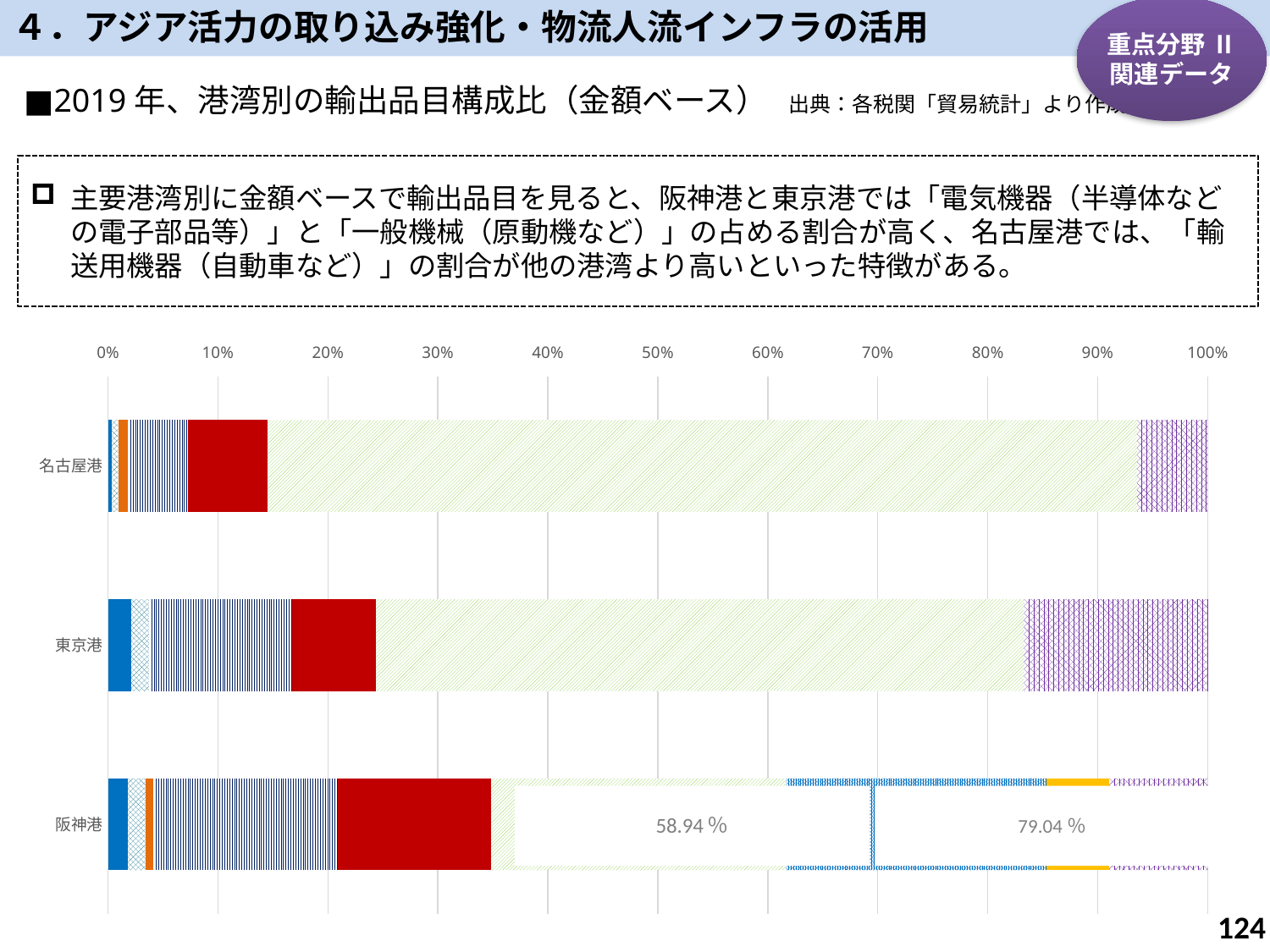
Is the red segment larger for 阪神港 or for 名古屋港? 阪神港 What is the total of each stacked bar, as shown by the right end of the bars on the axis? 100% How many ports (categories) are plotted in the chart? 3 Which port is shown in the top bar of the chart? 名古屋港 What is the title of the chart on the slide? 2019年、港湾別の輸出品目構成比（金額ベース） Is the green hatched segment larger for 名古屋港 or for 東京港? 名古屋港 Which port has the smallest purple cross-hatched segment at the right end of its bar? 名古屋港 Is the point where the green hatched segment for 東京港 ends greater or less than 70%? greater What kind of chart is shown on the slide? stacked bar chart Is the point where the red segment for 名古屋港 ends greater or less than 20%? less Which port has the largest green hatched segment in its bar? 名古屋港 Which port has the largest purple cross-hatched segment at the right end of its bar? 東京港